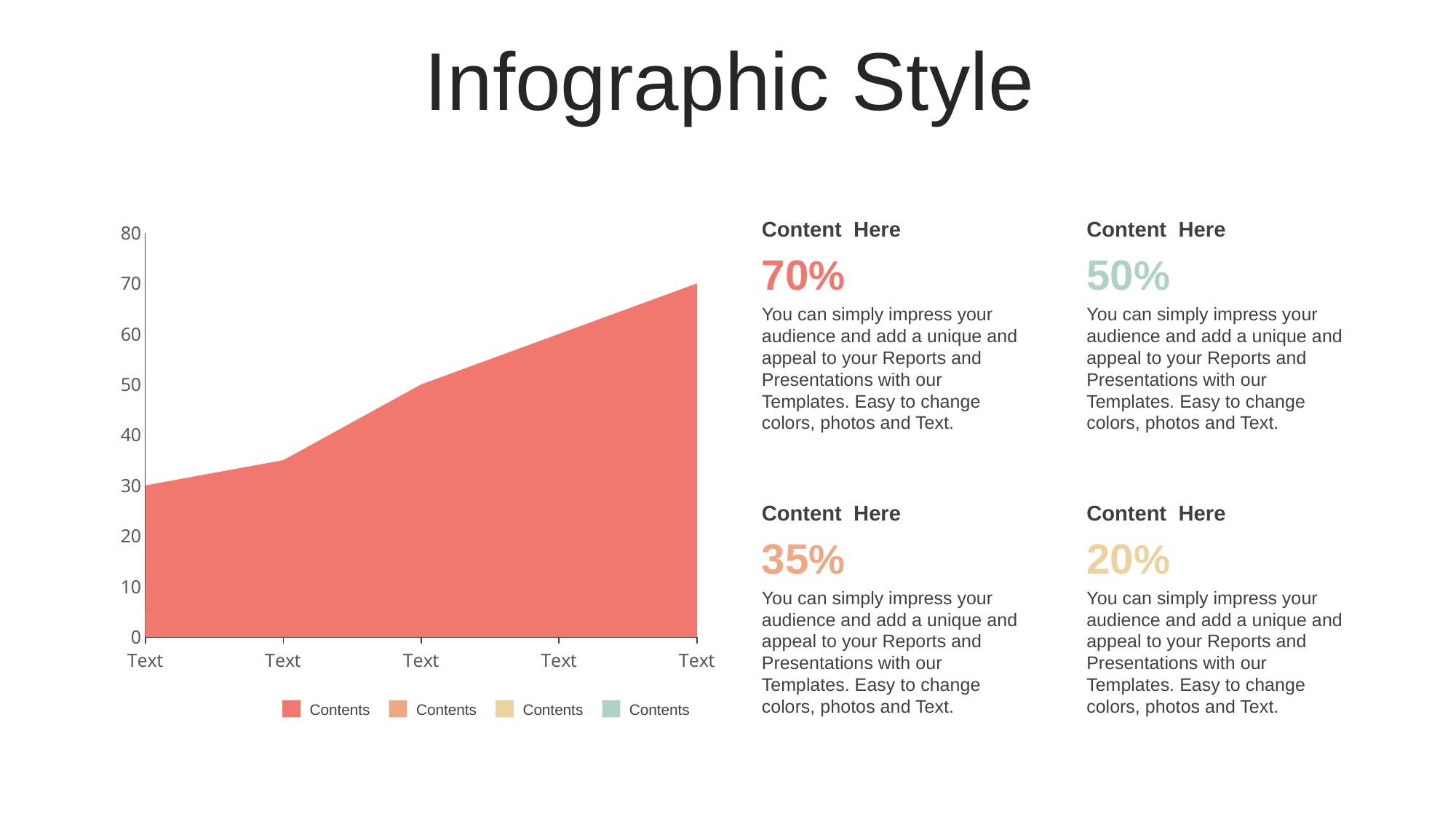
Which point in the chart has the highest value, the leftmost or the rightmost? rightmost What is the value of the last (rightmost) point in the chart? 70 Do the values in the chart rise or fall from left to right along the x axis? rise Is the value of the second point from the left greater or less than 40? less What is the difference between the last point and the first point in the chart? 40 How many entries does the chart's legend list? 4 What is the value of the first (leftmost) point in the chart? 30 What is the value of the third point from the left in the chart? 50 How many data points are plotted along the x axis of the chart? 5 What kind of chart is shown on the slide? area chart What is the highest value shown on the chart's vertical axis? 80 What is the value of the fourth point from the left in the chart? 60